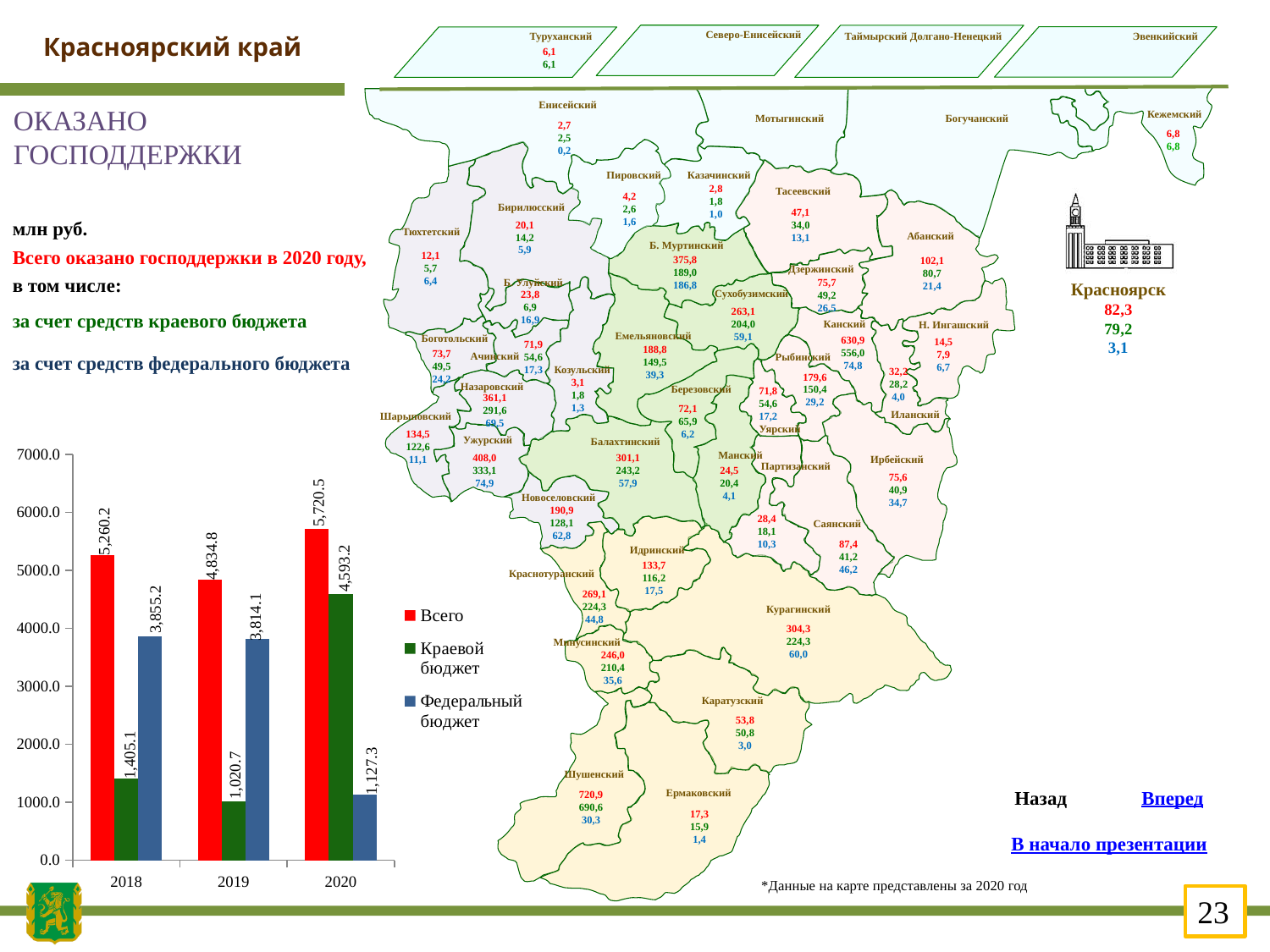
In which year is the Всего bar the highest? 2020 Is the Всего value for 2019 greater or less than 4000? greater In which year is the Всего bar the lowest? 2019 What kind of chart is used to show the values for 2018, 2019 and 2020? bar chart What is the value of the Всего bar for 2020? 5,720.5 What is the value of the Федеральный бюджет bar for 2019? 3,814.1 What is the difference between the Всего values for 2020 and 2018? 460.3 What is the difference between the Краевой бюджет values for 2018 and 2019? 384.4 How many series does the legend of the bar chart list? 3 How many years are shown on the x axis of the bar chart? 3 What is the value of the Краевой бюджет bar for 2018? 1,405.1 Which is larger in 2020: Краевой бюджет or Федеральный бюджет? Краевой бюджет